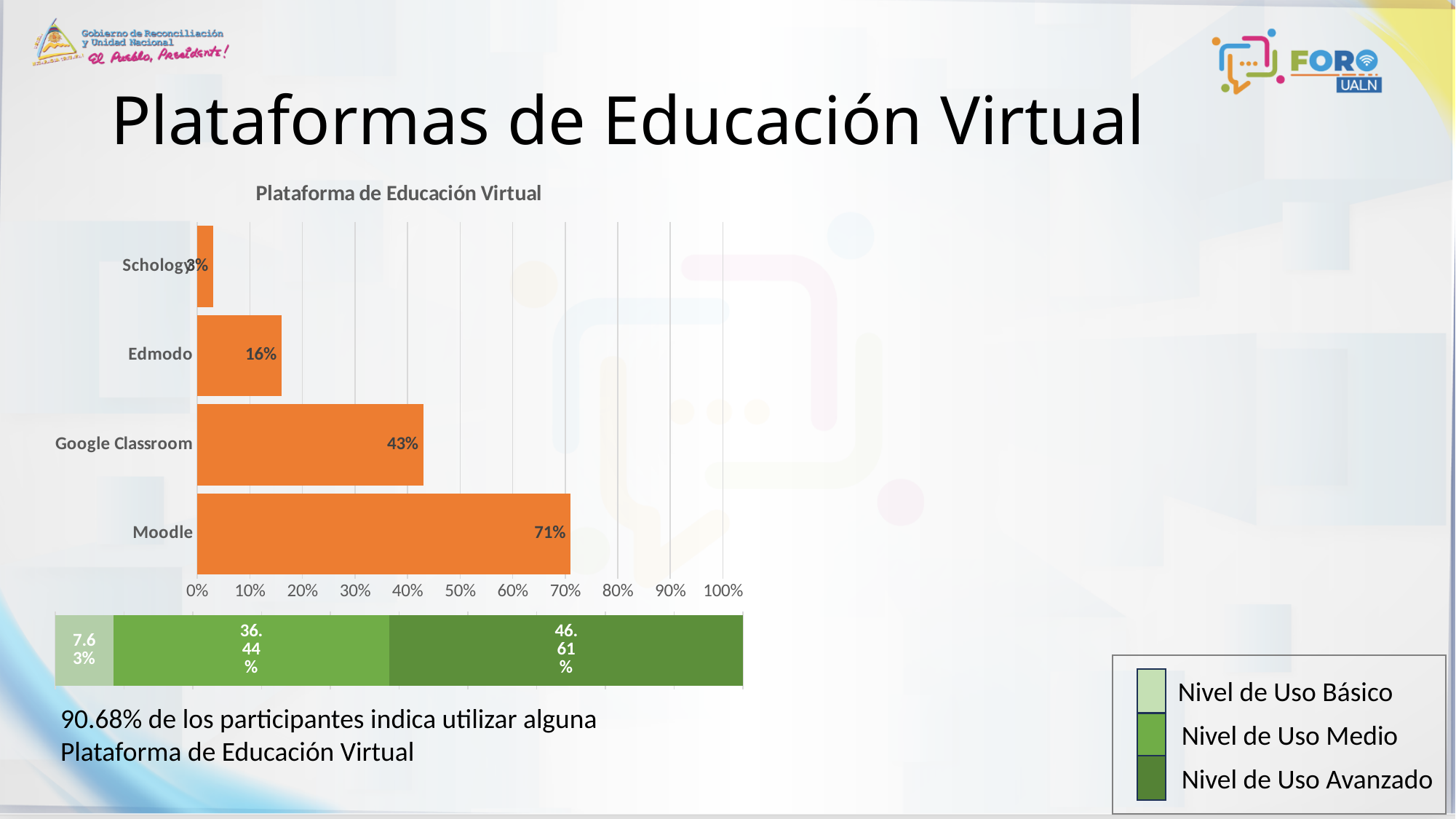
In the 'Plataforma de Educación Virtual' bar chart, which platform has the highest value? Moodle In the 'Plataforma de Educación Virtual' bar chart, which platform has the lowest value? Schology In the 'Plataforma de Educación Virtual' bar chart, what is the value for Google Classroom? 43% How many entries does the legend for the stacked bar at the bottom of the slide list? 3 In the 'Plataforma de Educación Virtual' bar chart, what is the difference between the values for Moodle and Google Classroom? 28% In the stacked bar at the bottom of the slide, what is the value for Nivel de Uso Básico? 7.63% What kind of chart is the 'Plataforma de Educación Virtual' chart? Bar chart In the stacked bar at the bottom of the slide, what is the value for Nivel de Uso Avanzado? 46.61% In the 'Plataforma de Educación Virtual' bar chart, which is larger, the value for Edmodo or the value for Google Classroom? Google Classroom In the 'Plataforma de Educación Virtual' bar chart, what is the value for Moodle? 71% In the 'Plataforma de Educación Virtual' bar chart, what is the value for Edmodo? 16% In the 'Plataforma de Educación Virtual' bar chart, how many platforms are shown? 4